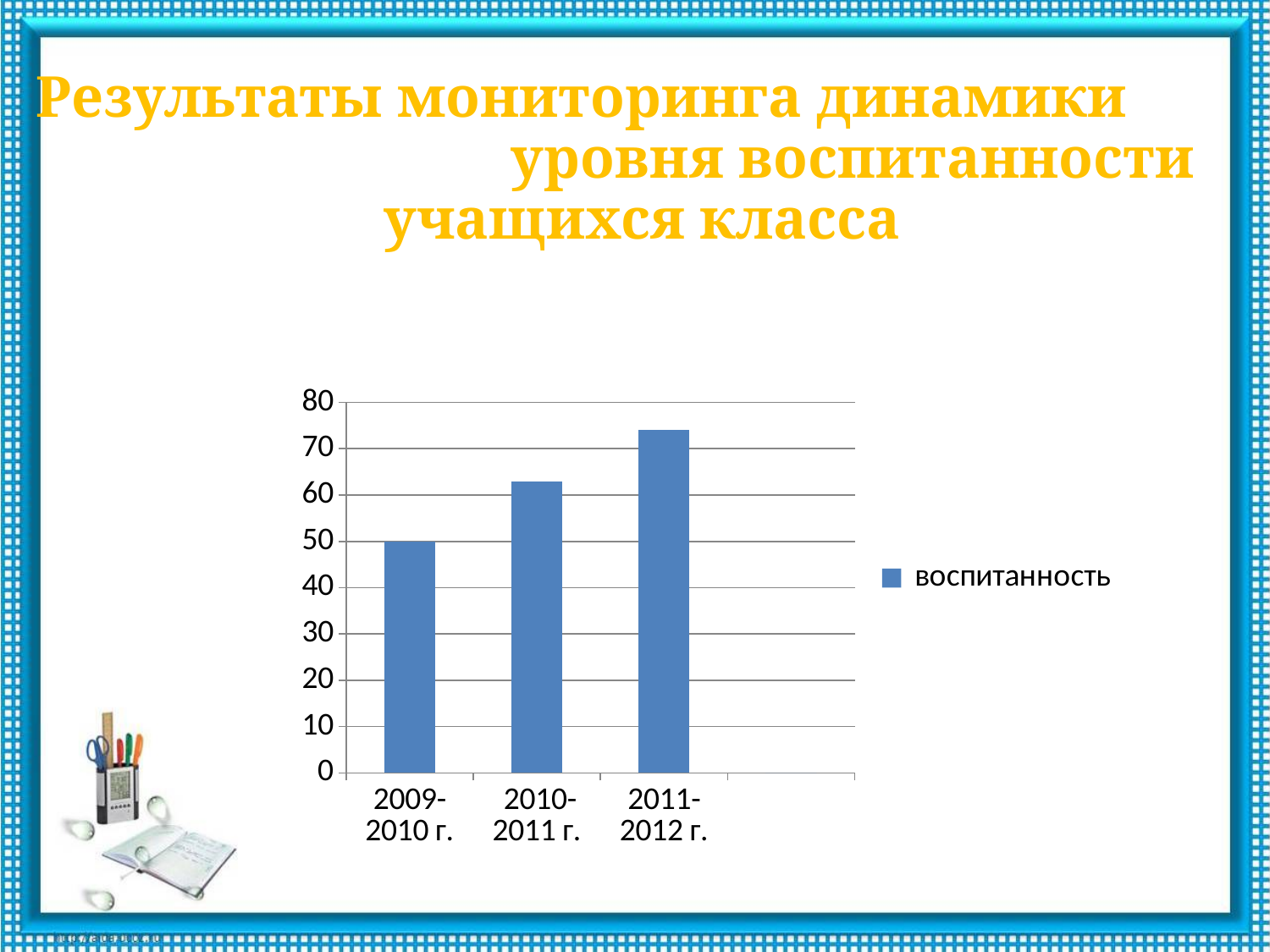
Which school year has the lowest value in the chart? 2009-2010 г. Do the values rise or fall from 2009-2010 г. to 2011-2012 г. along the x axis? rise Which school year has the highest value in the chart? 2011-2012 г. Is the value for 2010-2011 г. greater or less than 60? greater What is the value for 2009-2010 г. in the chart? 50 Is the value for 2010-2011 г. greater or less than 70? less What is the name of the series shown in the chart's legend? воспитанность Which is larger: the value for 2010-2011 г. or the value for 2011-2012 г.? 2011-2012 г. Is the value for 2011-2012 г. greater or less than 70? greater How many categories (school years) are shown on the x axis of the chart? 3 What kind of chart is shown on the slide? bar chart How many series does the chart's legend list? 1